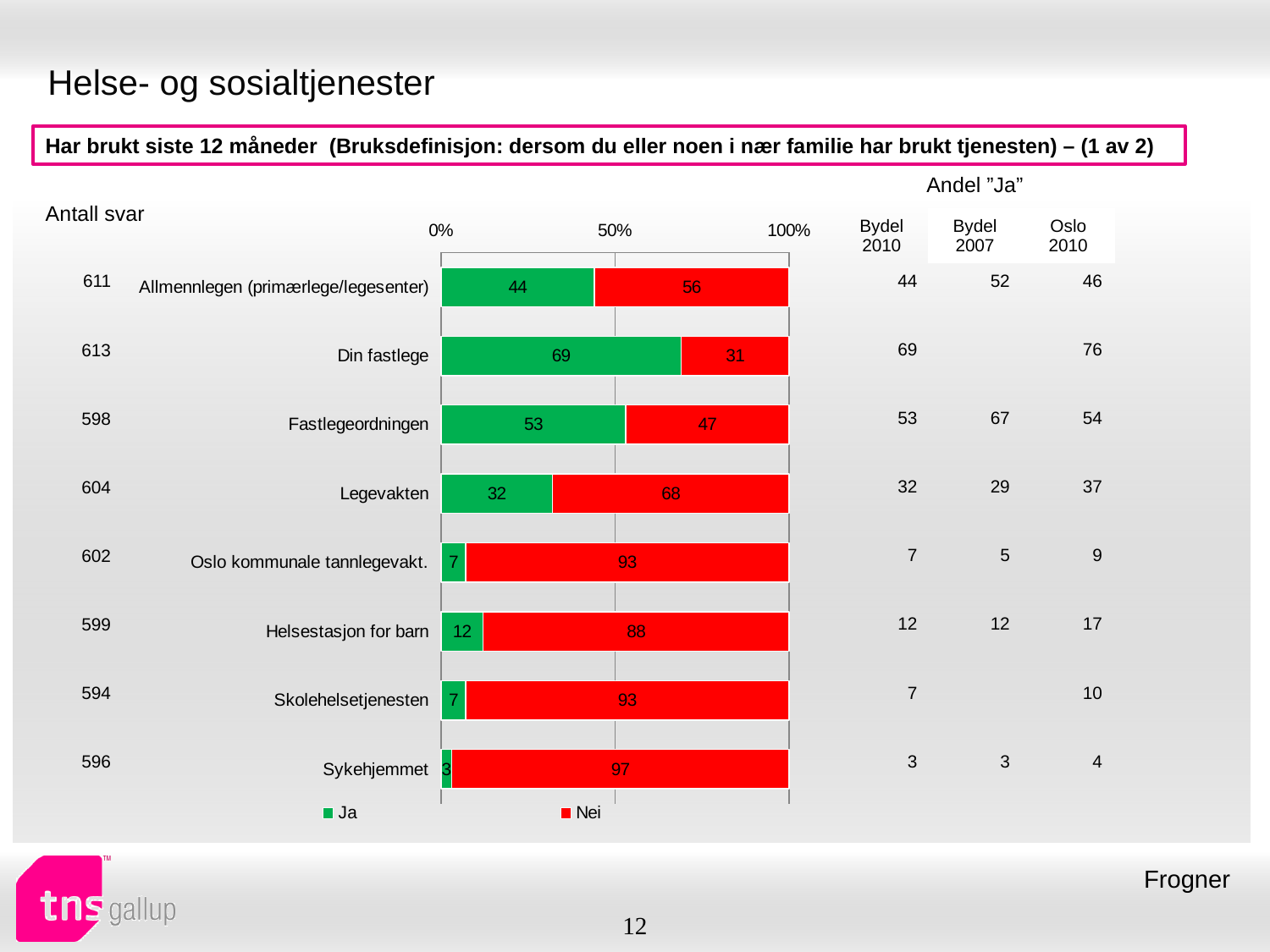
What is the "Nei" value for Legevakten? 68 Which category has the lowest "Ja" value? Sykehjemmet What kind of chart is shown on the slide? Stacked bar chart What is the "Ja" value for Helsestasjon for barn? 12 What is the "Ja" value for Din fastlege? 69 What are the two series listed in the legend? Ja and Nei Which is larger, the "Ja" value for Fastlegeordningen or the "Ja" value for Legevakten? Fastlegeordningen How many series does the legend list? 2 Which category has the highest "Ja" value? Din fastlege What is the difference between the "Nei" values for Sykehjemmet and Allmennlegen (primærlege/legesenter)? 41 How many categories are shown in the chart? 8 What is the total of the stacked bar for Fastlegeordningen? 100